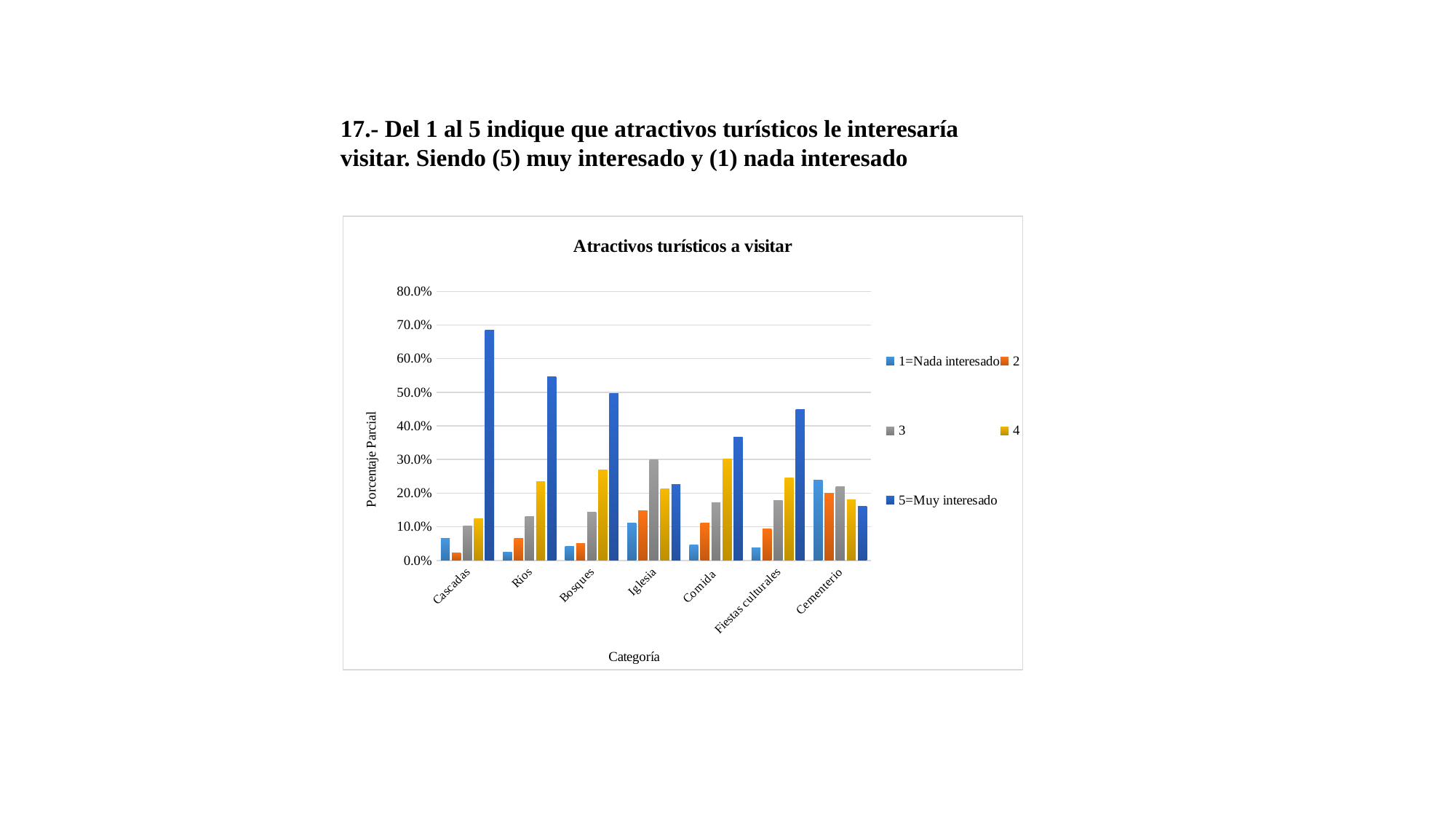
For Cementerio, which series has the larger value: 1=Nada interesado or 5=Muy interesado? 1=Nada interesado Is the value for Ríos in the series 5=Muy interesado greater or less than 50.0%? greater Which category has the highest value for the series 5=Muy interesado? Cascadas What kind of chart is shown on the slide? bar chart How many series does the legend of the chart list? 5 Is the value for Cascadas in the series 5=Muy interesado greater or less than 60.0%? greater What is the title of the vertical axis of the chart? Porcentaje Parcial Which category has the highest value for the series 1=Nada interesado? Cementerio How many categories are shown on the x axis of the chart? 7 Which category has the lowest value for the series 5=Muy interesado? Cementerio Is the value for Bosques in the series 4 greater or less than 20.0%? greater For Iglesia, which series has the larger value: 3 or 4? 3